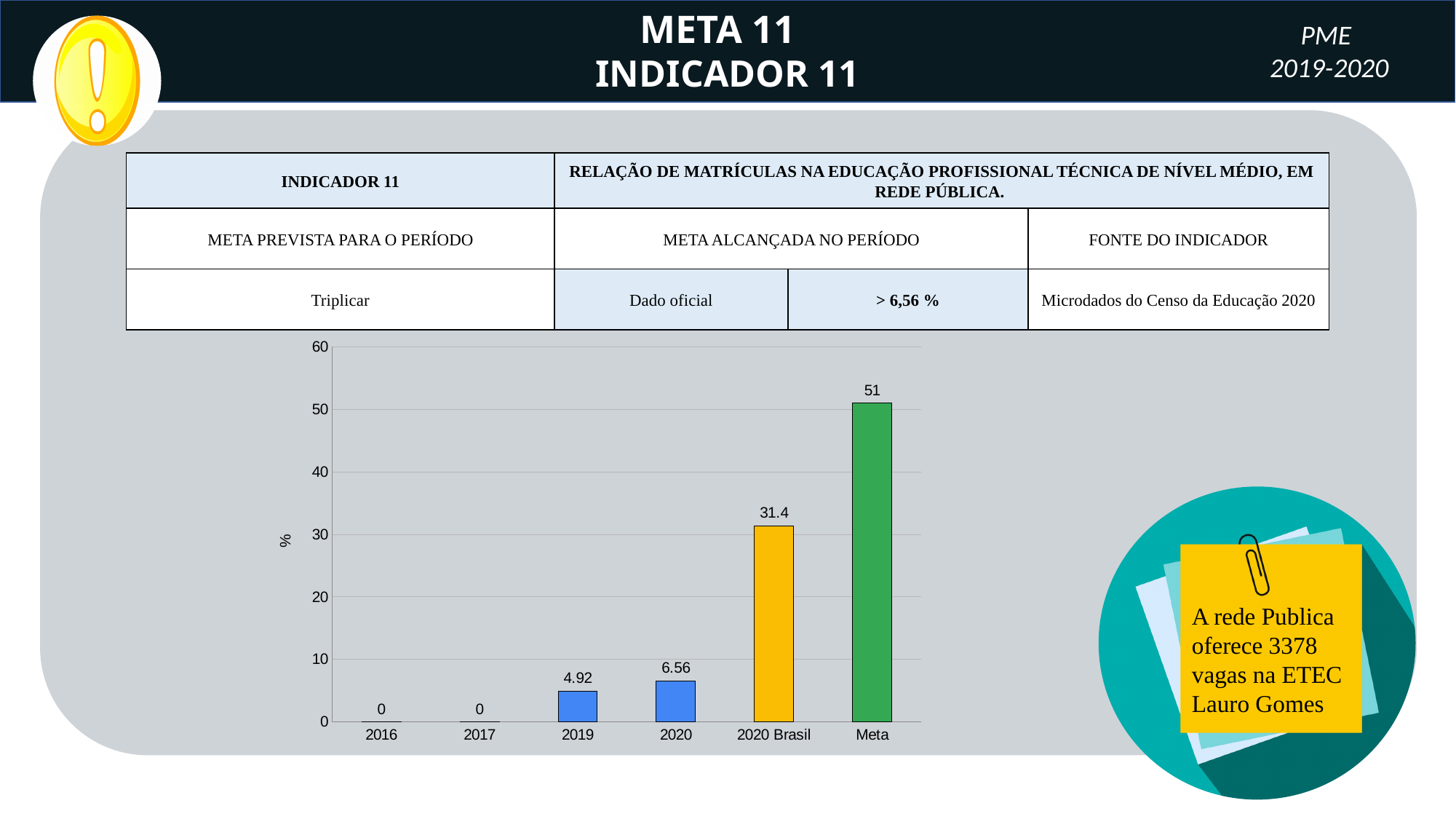
What is the value for 2020 in the bar chart? 6.56 What is the label on the y axis of the chart? % Which is larger, the value for 2020 or the value for 2020 Brasil? 2020 Brasil What kind of chart is shown on the slide? bar chart What is the difference between the 2020 value and the 2019 value? 1.64 What is the value for 2020 Brasil in the bar chart? 31.4 Is the value for 2020 Brasil greater or less than 30? greater How many categories are shown on the x axis of the bar chart? 6 What is the difference between the Meta value and the 2020 Brasil value? 19.6 What is the value for 2019 in the bar chart? 4.92 What is the value for Meta in the bar chart? 51 Which category has the highest value in the bar chart? Meta